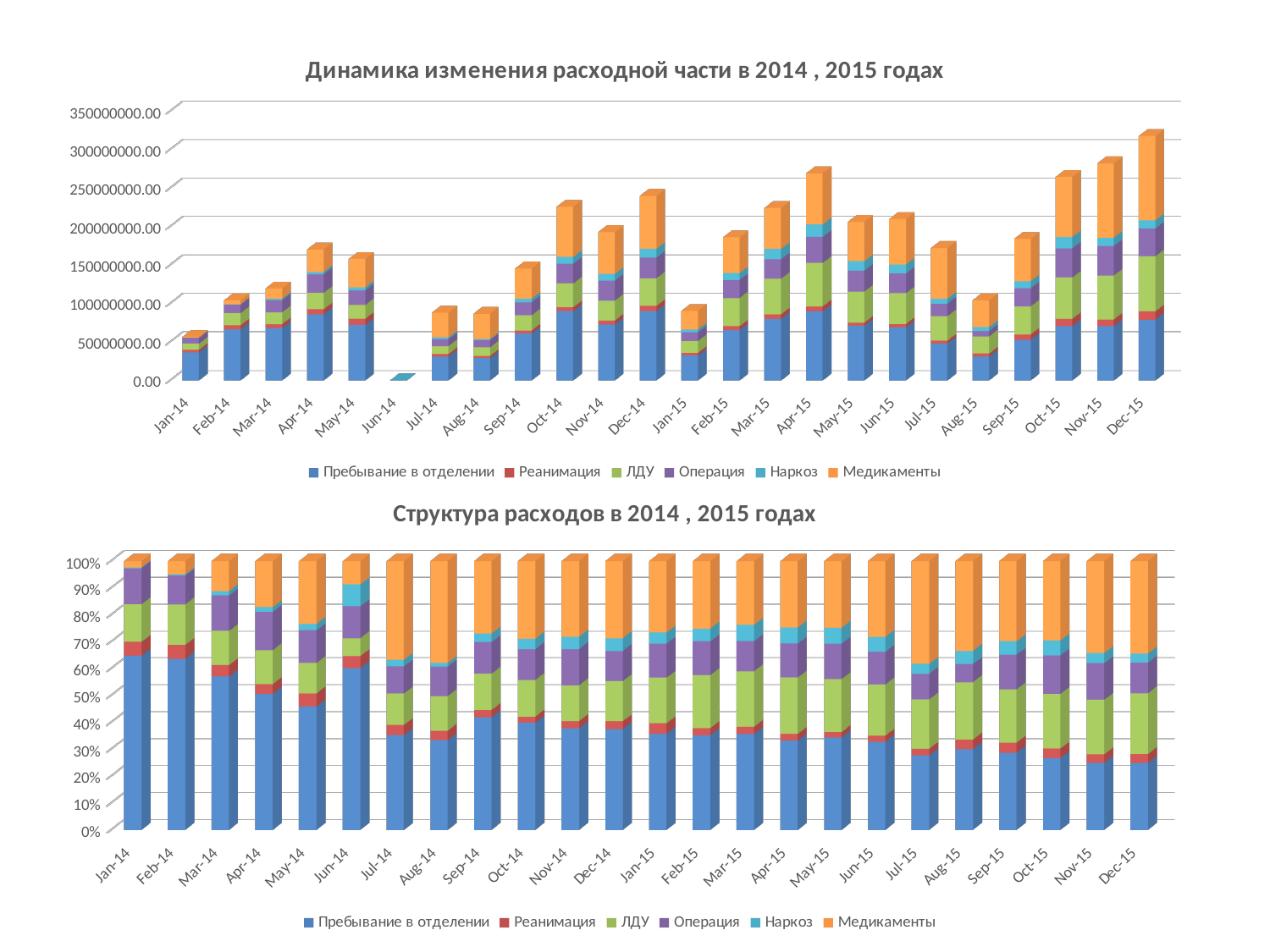
In the top chart, which month has the lowest total bar? Jun-14 In the bottom chart titled "Структура расходов в 2014 , 2015 годах", is the share of "Пребывание в отделении" for Jan-14 greater or less than 60%? greater In the bottom chart, is the share of "Пребывание в отделении" for Dec-15 greater or less than 30%? less In the top chart, which month has the larger total bar, Nov-14 or Dec-14? Dec-14 In the top chart, is the total for Jan-15 greater or less than 100000000.00? less What is the last series listed in the legend of the bottom chart? Медикаменты What kind of chart is the top chart titled "Динамика изменения расходной части в 2014 , 2015 годах"? Stacked bar chart How many months (categories) are shown on the x axis of the top chart? 24 How many series does the legend of the top chart list? 6 In the top chart, which month has the highest total bar? Dec-15